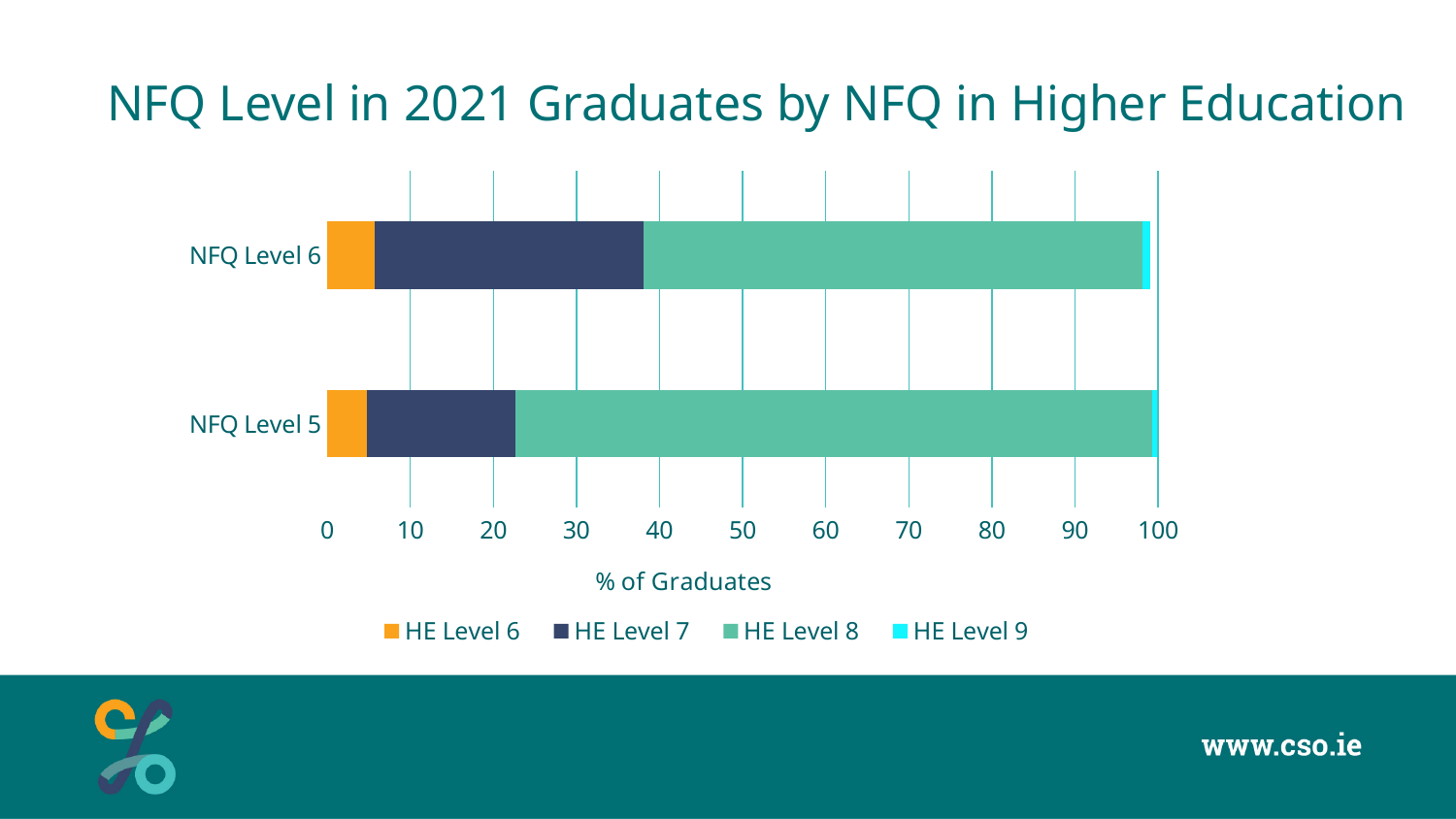
Which series makes up the largest share of the NFQ Level 5 bar? HE Level 8 Is the HE Level 7 value for NFQ Level 6 greater or less than 20? greater Is the HE Level 7 share for NFQ Level 6 larger or smaller than the HE Level 7 share for NFQ Level 5? Larger How many series does the legend list? 4 Which legend entry is shown in orange? HE Level 6 How many NFQ level categories are plotted on the chart? 2 Which series makes up the smallest share of the NFQ Level 6 bar? HE Level 9 Which NFQ level has the larger HE Level 8 share, NFQ Level 5 or NFQ Level 6? NFQ Level 5 Is the HE Level 8 value for NFQ Level 5 greater or less than 70? greater What is the title of the horizontal axis? % of Graduates What kind of chart is shown on the slide? Stacked bar chart Is the HE Level 6 value for NFQ Level 5 greater or less than 10? less